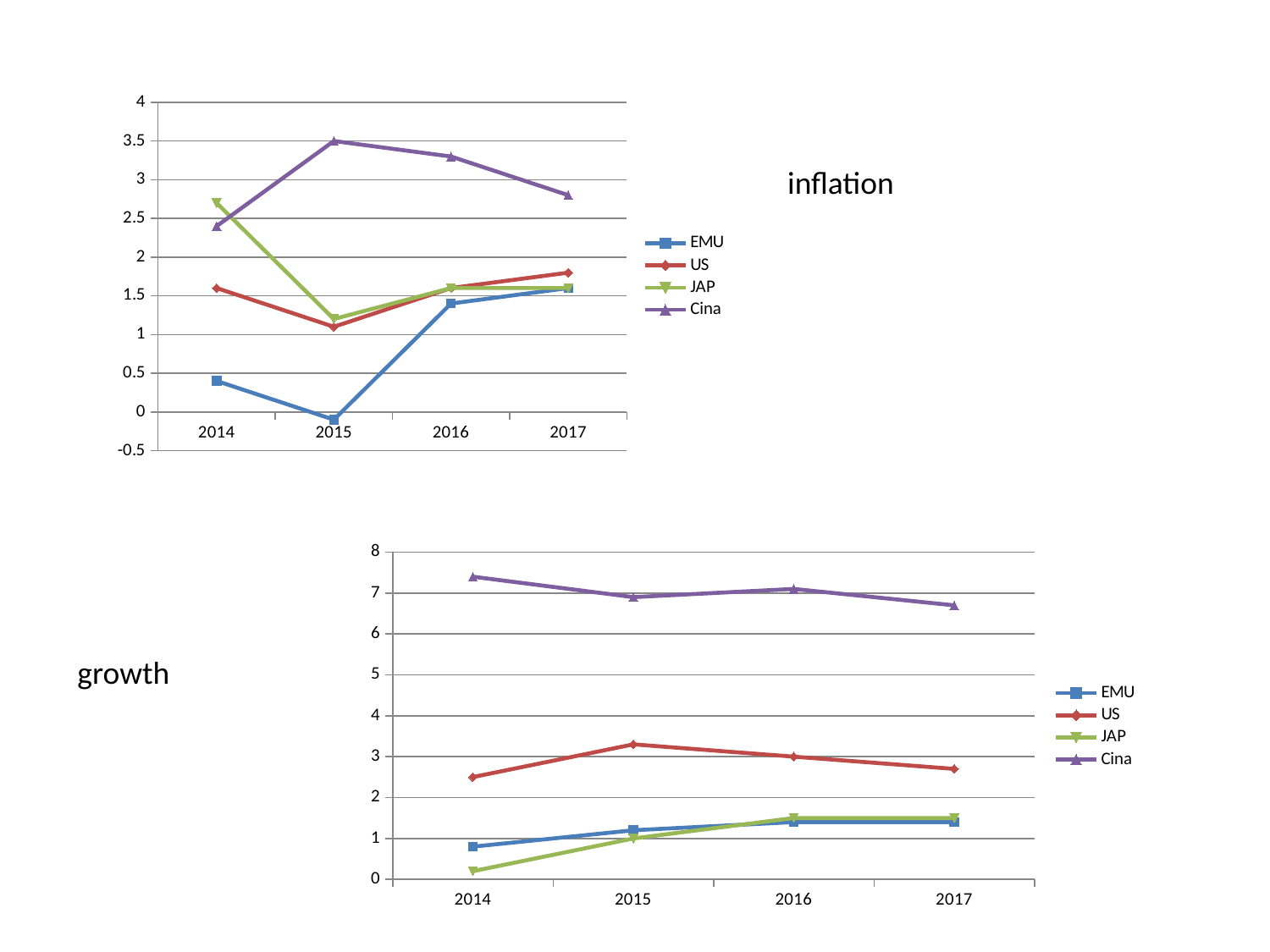
How many series does the legend of the growth chart list? 4 In the growth chart, is the value for Cina in 2014 greater or less than 7? greater In the inflation chart, is the value for Cina in 2015 greater or less than 3? greater In the growth chart, which series has the highest value in 2017? Cina In the growth chart, does the US series rise or fall from 2015 to 2017? fall In the growth chart, which is larger in 2014, the value for US or the value for EMU? US In the inflation chart, which series has the highest value in 2015? Cina How many years are shown on the x axis of the inflation chart? 4 What kind of chart is the inflation chart at the top of the slide? line chart In the inflation chart, which series has the lowest value in 2015? EMU Which series is drawn in purple in the inflation chart? Cina In the inflation chart, is the value for EMU in 2015 greater or less than 0? less